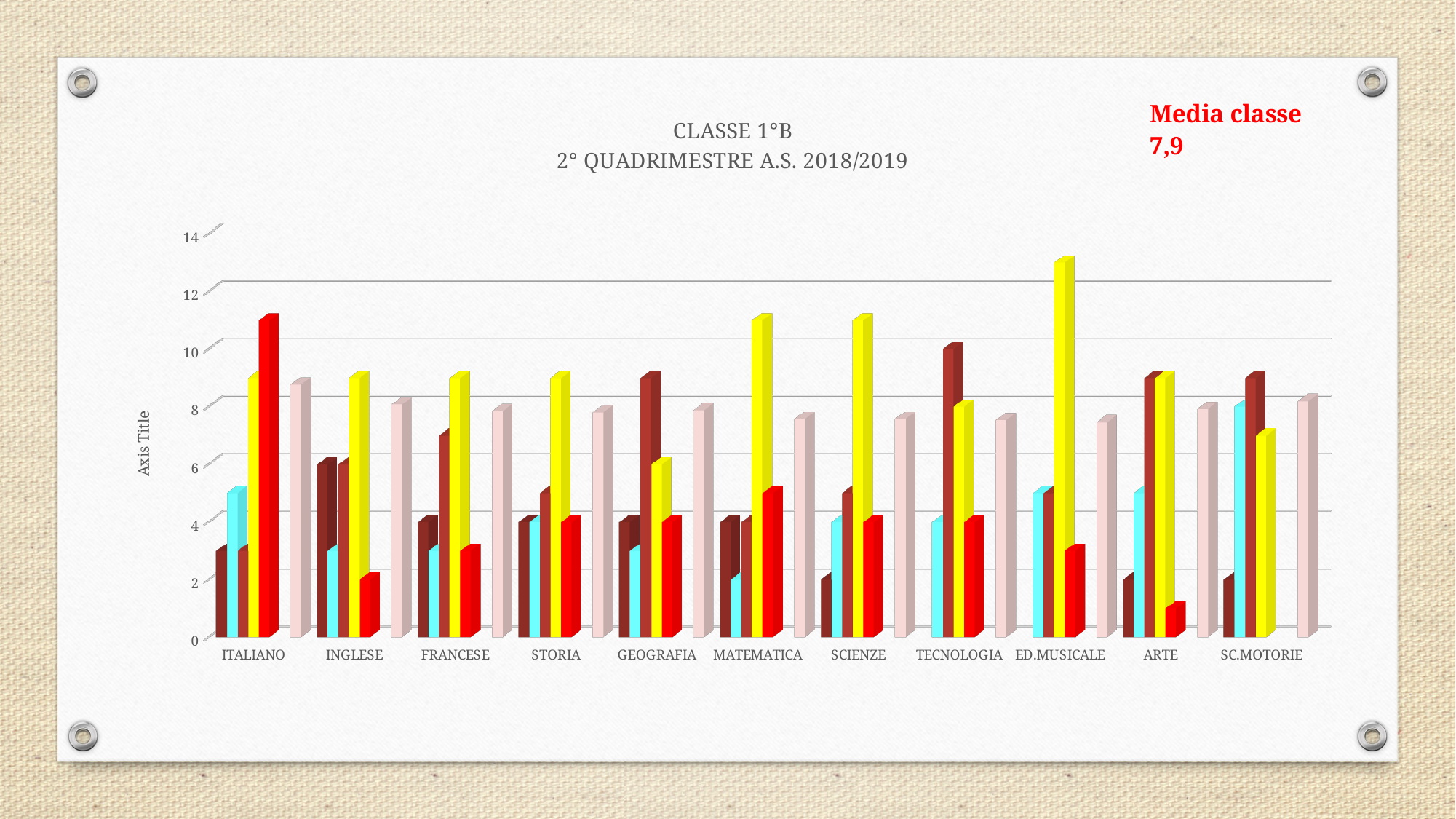
What is the title of the chart? CLASSE 1°B 2° QUADRIMESTRE A.S. 2018/2019 What is the label on the vertical axis of the chart? Axis Title For which subject is the red bar the shortest? ARTE For which subject is the yellow bar the shortest? GEOGRAFIA Which is larger: the red bar for ITALIANO or the red bar for INGLESE? ITALIANO Is the yellow bar for ED.MUSICALE greater or less than 12? greater How many subject categories are shown on the x axis of the chart? 11 For which subject is the red bar the tallest? ITALIANO For which subject is the yellow bar the tallest? ED.MUSICALE Is the red bar for ITALIANO greater or less than 10? greater What kind of chart is shown on the slide? Bar chart Is the yellow bar for GEOGRAFIA greater or less than 8? less